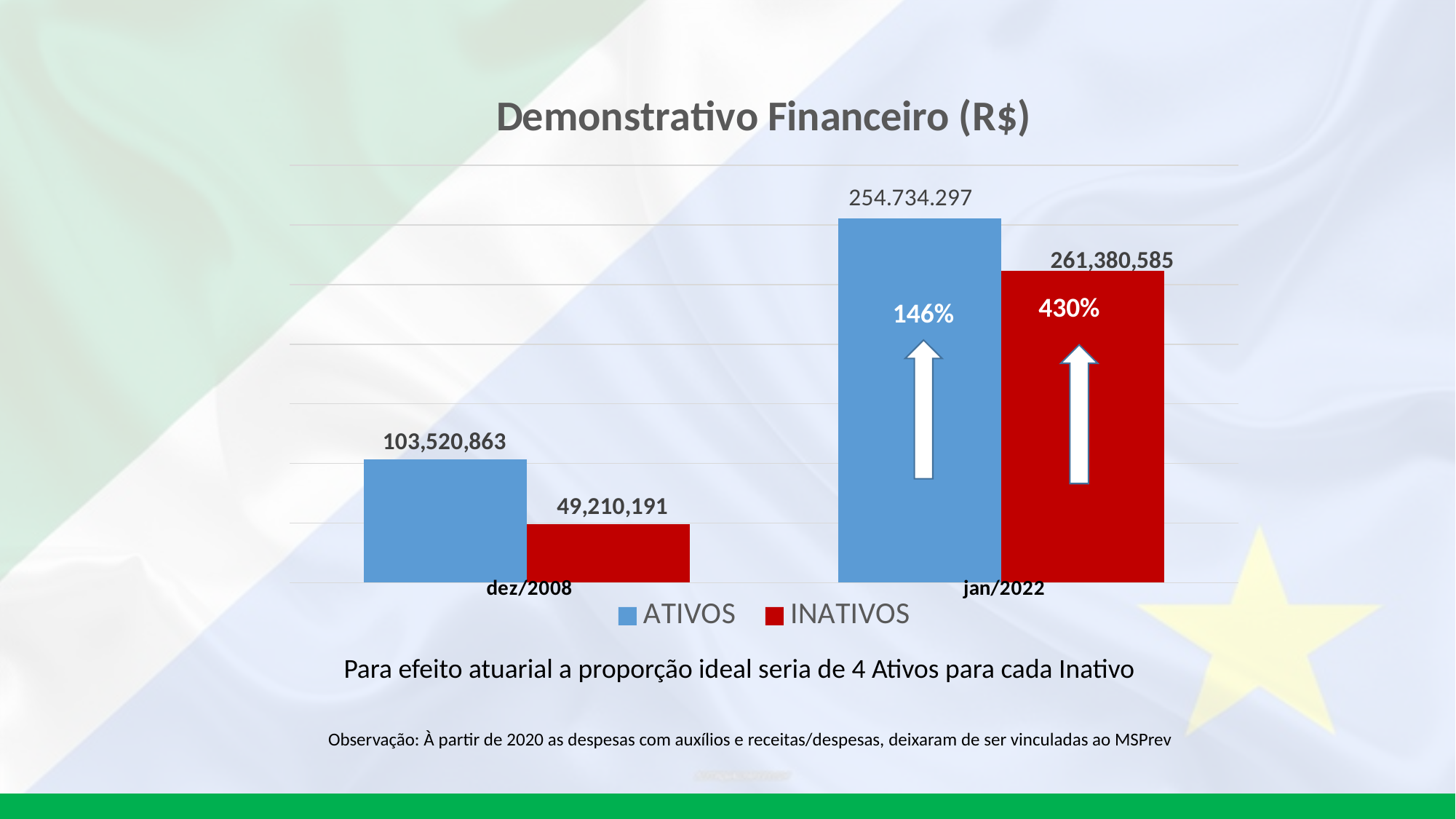
What is the value for INATIVOS in jan/2022? 261,380,585 How many categories are shown on the x axis? 2 What is the difference between ATIVOS and INATIVOS in dez/2008? 54,310,672 What is the value for ATIVOS in jan/2022? 254.734.297 Does the value for ATIVOS rise or fall from dez/2008 to jan/2022? Rise What is the value for ATIVOS in dez/2008? 103,520,863 What kind of chart is shown on the slide? Bar chart What percentage label is shown on the INATIVOS bar for jan/2022? 430% In dez/2008, which is larger, ATIVOS or INATIVOS? ATIVOS How many series does the legend list? 2 What is the value for INATIVOS in dez/2008? 49,210,191 Which bar has the lowest value in the chart? INATIVOS in dez/2008